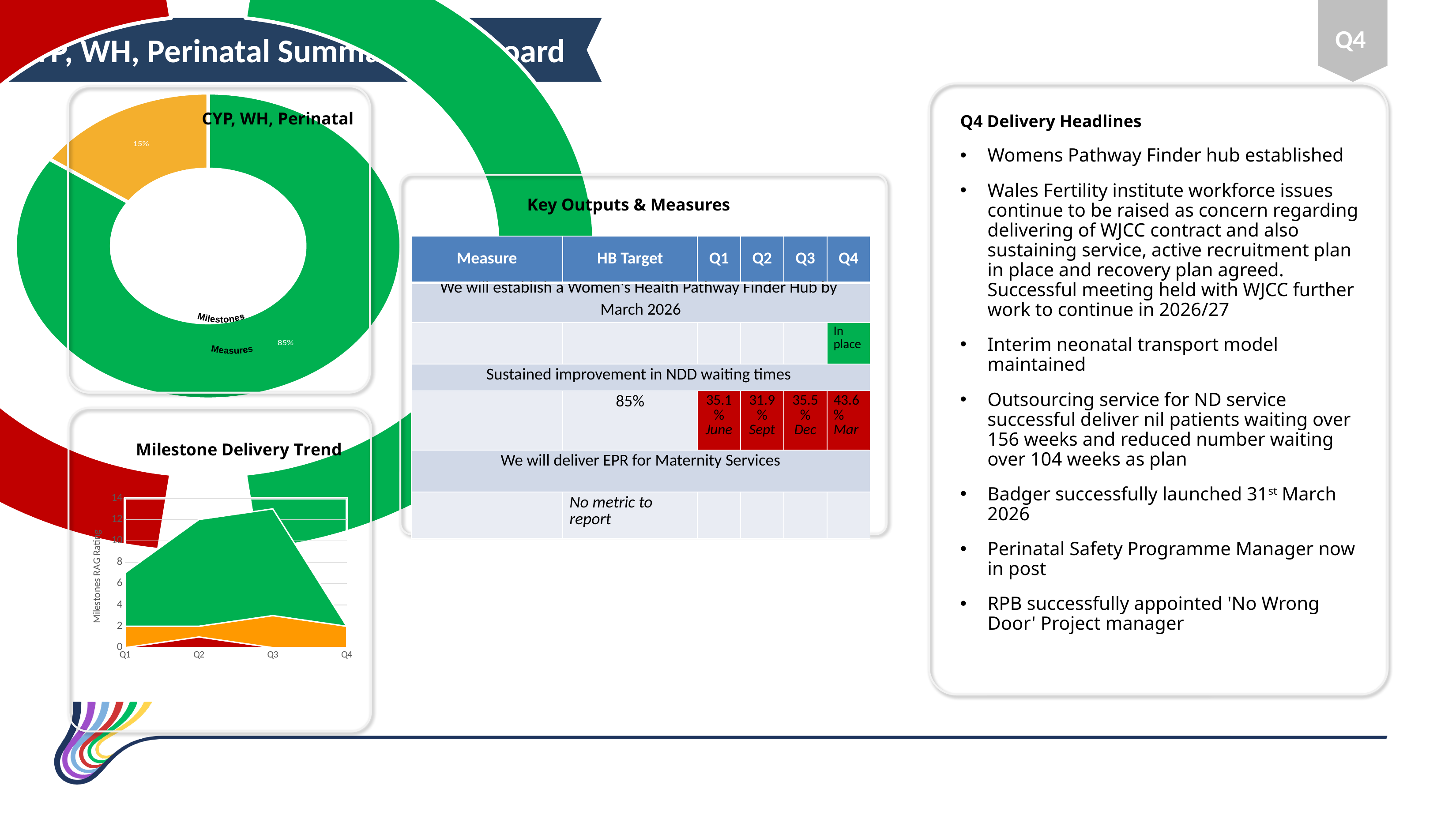
How many quarters are shown on the x axis of the Milestone Delivery Trend chart? 4 In the CYP, WH, Perinatal chart, what is the difference in percentage points between the green slice and the amber slice? 70 What kind of chart is the CYP, WH, Perinatal chart? doughnut chart What kind of chart is the Milestone Delivery Trend chart? stacked area chart In the CYP, WH, Perinatal chart, which slice is larger, the green one or the amber one? green In the Milestone Delivery Trend chart, is the total stacked value at Q4 greater or less than 4? less In the Milestone Delivery Trend chart, is the total stacked value at Q3 greater or less than 10? greater In the CYP, WH, Perinatal doughnut chart, what percentage is shown for the amber slice? 15% In the CYP, WH, Perinatal doughnut chart, what percentage is shown for the green slice? 85% What is the y-axis label of the Milestone Delivery Trend chart? Milestones RAG Rating In the Milestone Delivery Trend chart, which quarter has the lowest total stacked value? Q4